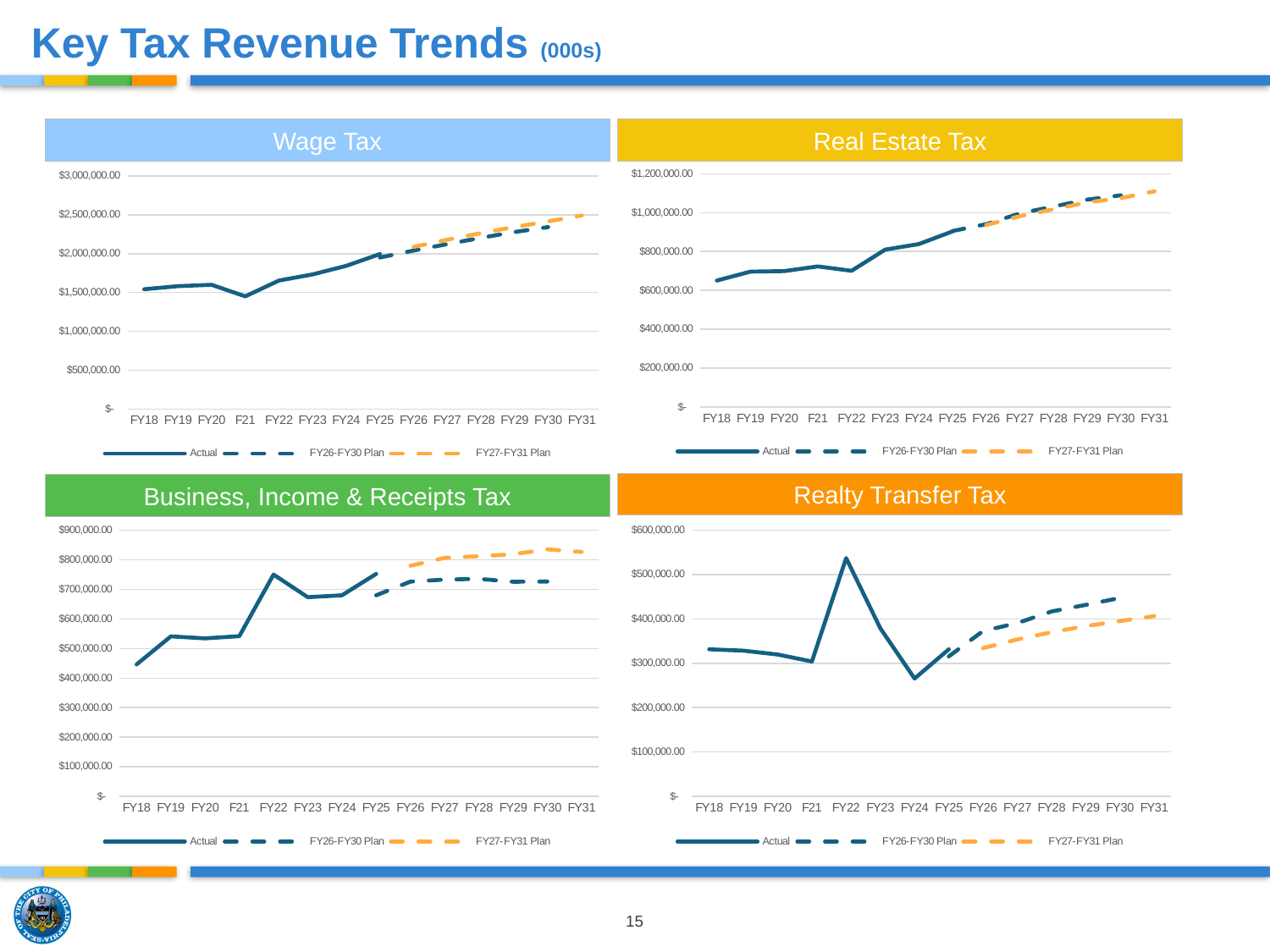
In the Real Estate Tax chart, is the FY27-FY31 Plan value for FY31 greater or less than $1,000,000.00? greater How many series does the legend of the Real Estate Tax chart list? 3 In the Realty Transfer Tax chart, is the Actual value for FY24 greater or less than $300,000.00? less In the Realty Transfer Tax chart, which is larger, the Actual value for FY22 or for FY24? FY22 What kind of chart is the Wage Tax chart? line chart In the Wage Tax chart, which fiscal year has the lowest Actual value? F21 In the Realty Transfer Tax chart, which fiscal year has the highest Actual value? FY22 In the Business, Income & Receipts Tax chart, which fiscal year has the lowest Actual value? FY18 In the Real Estate Tax chart, do the Actual values generally rise or fall from FY18 to FY25? rise In the Wage Tax chart, is the Actual value for FY24 greater or less than $2,000,000.00? less How many fiscal years are shown on the x axis of the Business, Income & Receipts Tax chart? 14